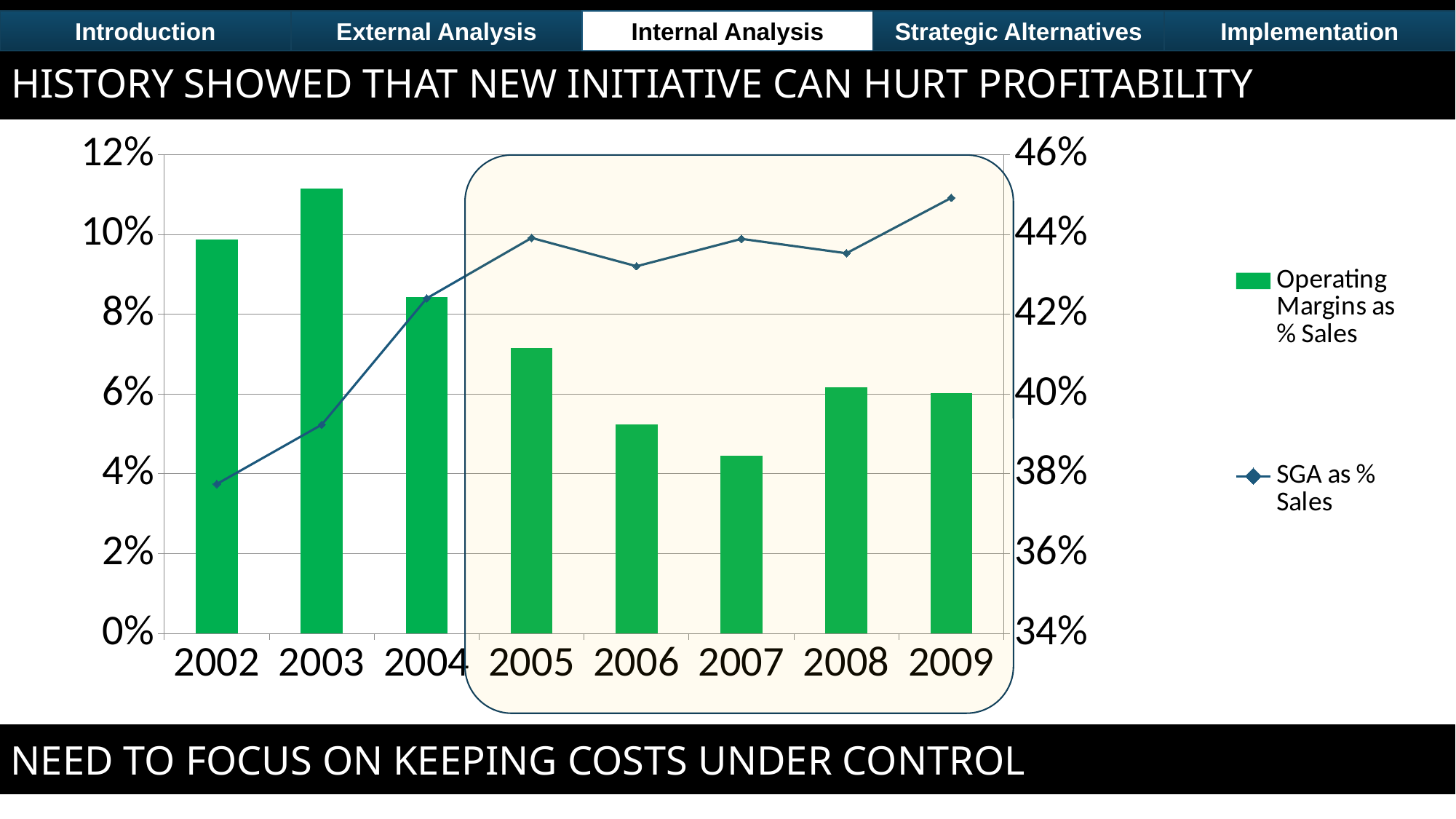
Does SGA as % Sales generally rise or fall from 2002 to 2009? Rise Is the SGA as % Sales value for 2002 greater or less than 38%? less Is the Operating Margins as % Sales value for 2003 greater or less than 10%? greater In which year is SGA as % Sales at its highest? 2009 Is the SGA as % Sales value for 2009 greater or less than 44%? greater How many series does the legend list? 2 Which year has the highest Operating Margins as % Sales bar? 2003 Which year has a higher Operating Margins as % Sales value, 2002 or 2006? 2002 How many years are shown on the x axis of the chart? 8 What kind of chart is shown on the slide? Combined bar and line chart Which year has the lowest Operating Margins as % Sales bar? 2007